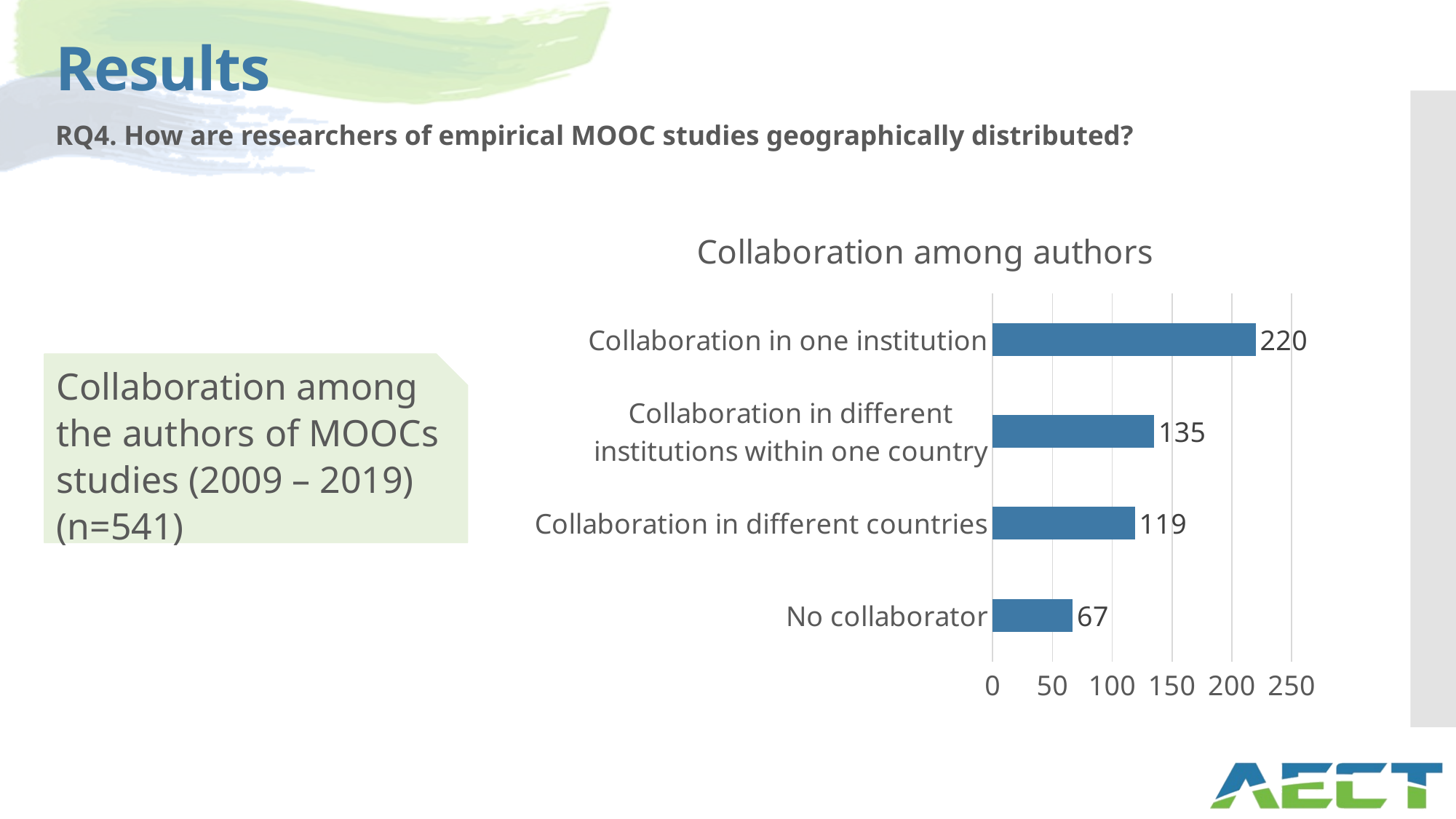
What is the value for Collaboration in different countries? 119 Which category has the highest value? Collaboration in one institution What is the difference between Collaboration in different institutions within one country and Collaboration in different countries? 16 What is the value for No collaborator? 67 What is the value for Collaboration in different institutions within one country? 135 What is the difference between Collaboration in one institution and No collaborator? 153 What is the value for Collaboration in one institution? 220 Which is larger: Collaboration in different countries or No collaborator? Collaboration in different countries What kind of chart is shown on the slide? Bar chart What is the title of the chart? Collaboration among authors How many categories are shown in the chart? 4 Which category has the lowest value? No collaborator